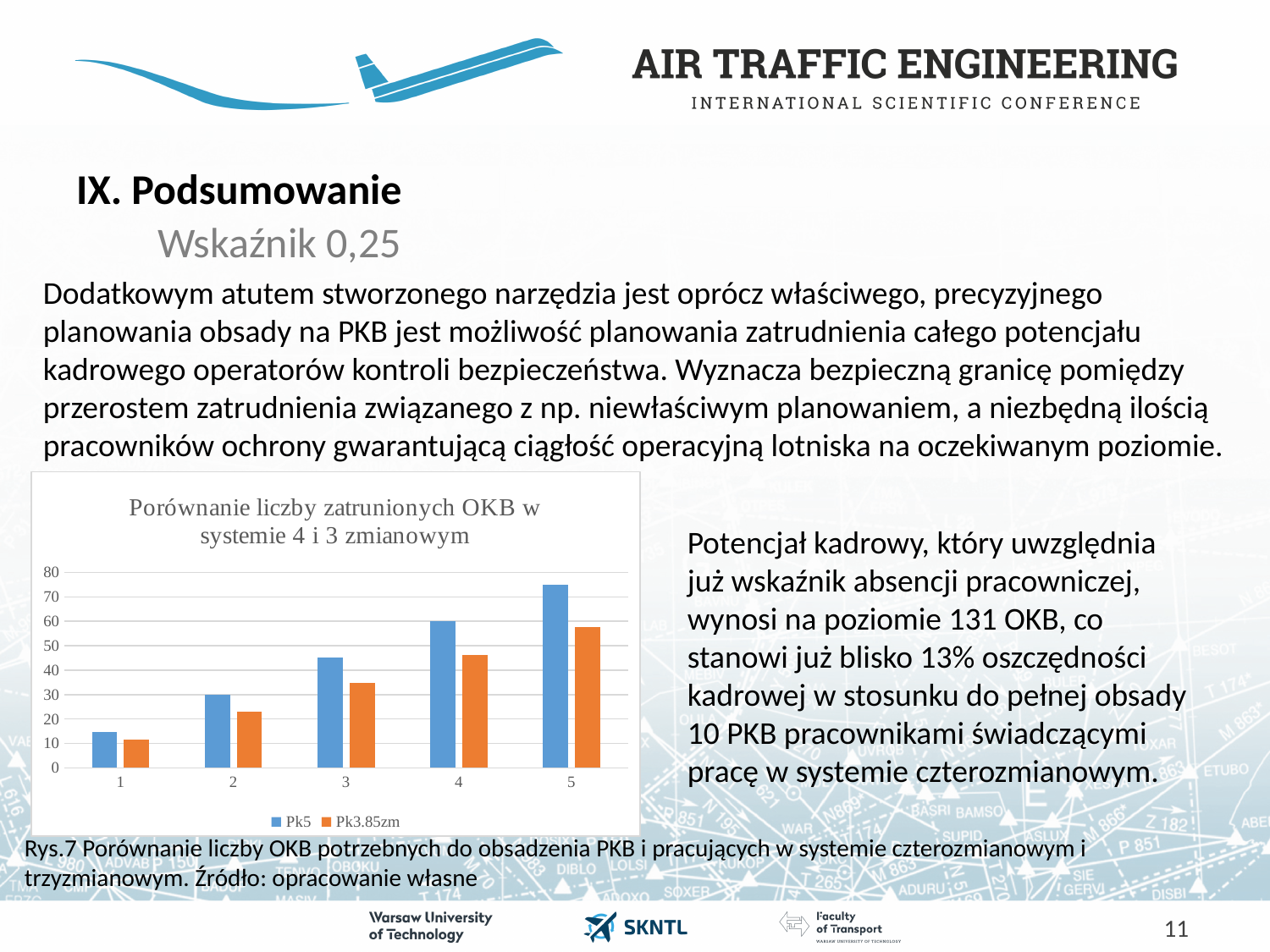
For category 3, which series has the larger value, Pk5 or Pk3.85zm? Pk5 Is the value of Pk3.85zm for category 1 greater or less than 20? less What kind of chart is shown on the slide? bar chart How many categories are shown on the x axis of the chart? 5 Is the value of Pk3.85zm for category 5 greater or less than 60? less For which category is the Pk3.85zm value lowest? 1 How many series does the chart legend list? 2 For which category is the Pk5 value highest? 5 What are the two series named in the chart legend? Pk5 and Pk3.85zm Is the value of Pk5 for category 5 greater or less than 70? greater What is the value of Pk5 for category 2? 30 What is the value of Pk5 for category 4? 60